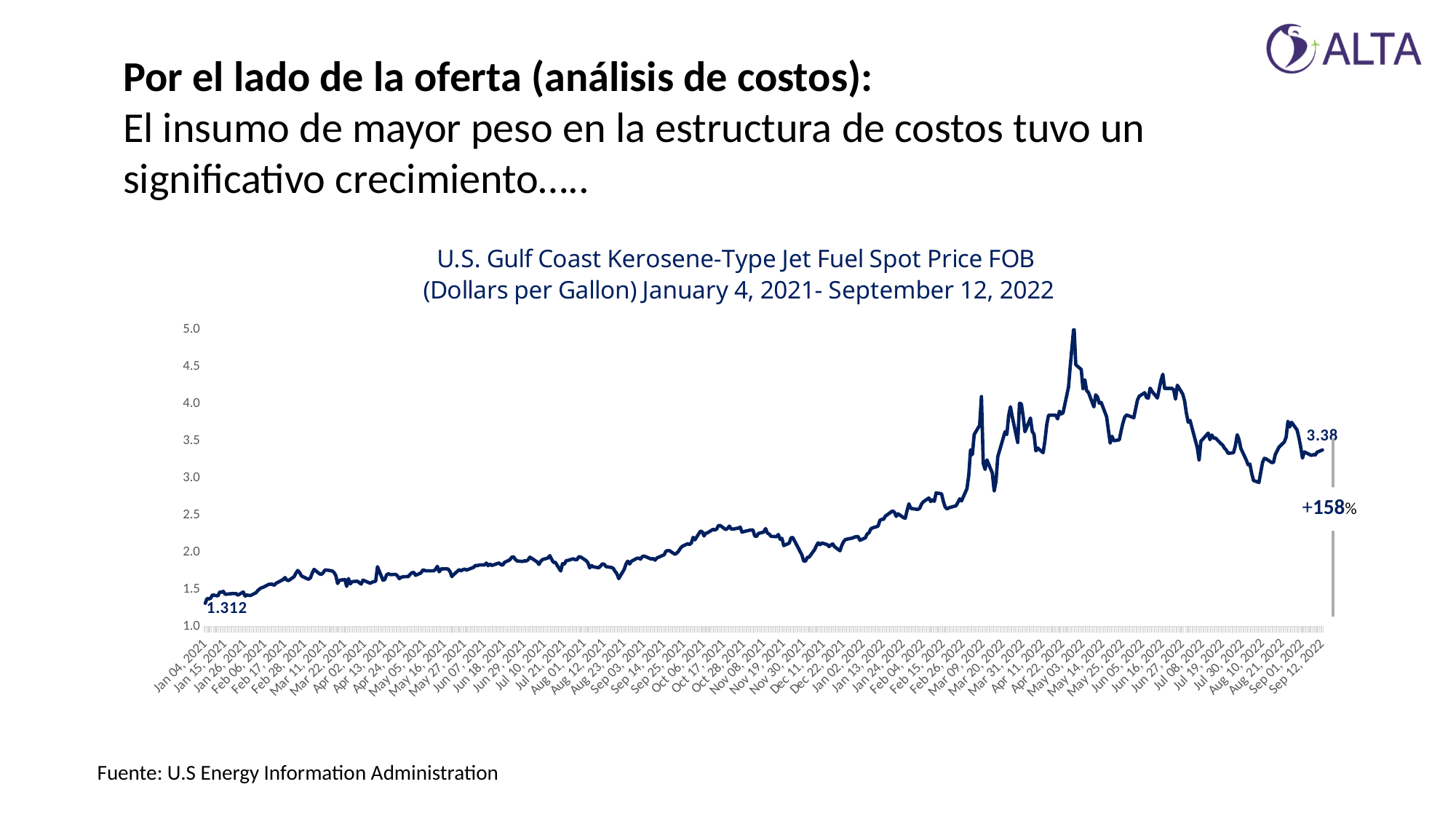
What is the difference between the labelled value on Sep 12, 2022 (3.38) and the labelled value on Jan 04, 2021 (1.312)? 2.068 Is the value around Oct 28, 2021 greater or less than 2.0? greater What is the title of the chart? U.S. Gulf Coast Kerosene-Type Jet Fuel Spot Price FOB (Dollars per Gallon) January 4, 2021- September 12, 2022 What is the jet fuel spot price labelled at the end of the series, on Sep 12, 2022? 3.38 Around which x-axis date does the line reach its highest value? May 03, 2022 Overall, does the jet fuel spot price rise or fall from January 2021 to September 2022? rise What is the jet fuel spot price labelled at the start of the series, on Jan 04, 2021? 1.312 Is the value on Jan 04, 2021 greater or less than 1.5? less What percentage change is annotated on the right side of the chart? +158% Which is larger, the value on Sep 12, 2022 or the value on Jan 04, 2021? Sep 12, 2022 Is the peak value of the line, reached around May 03, 2022, greater or less than 4.5? greater What kind of chart is shown on the slide? line chart